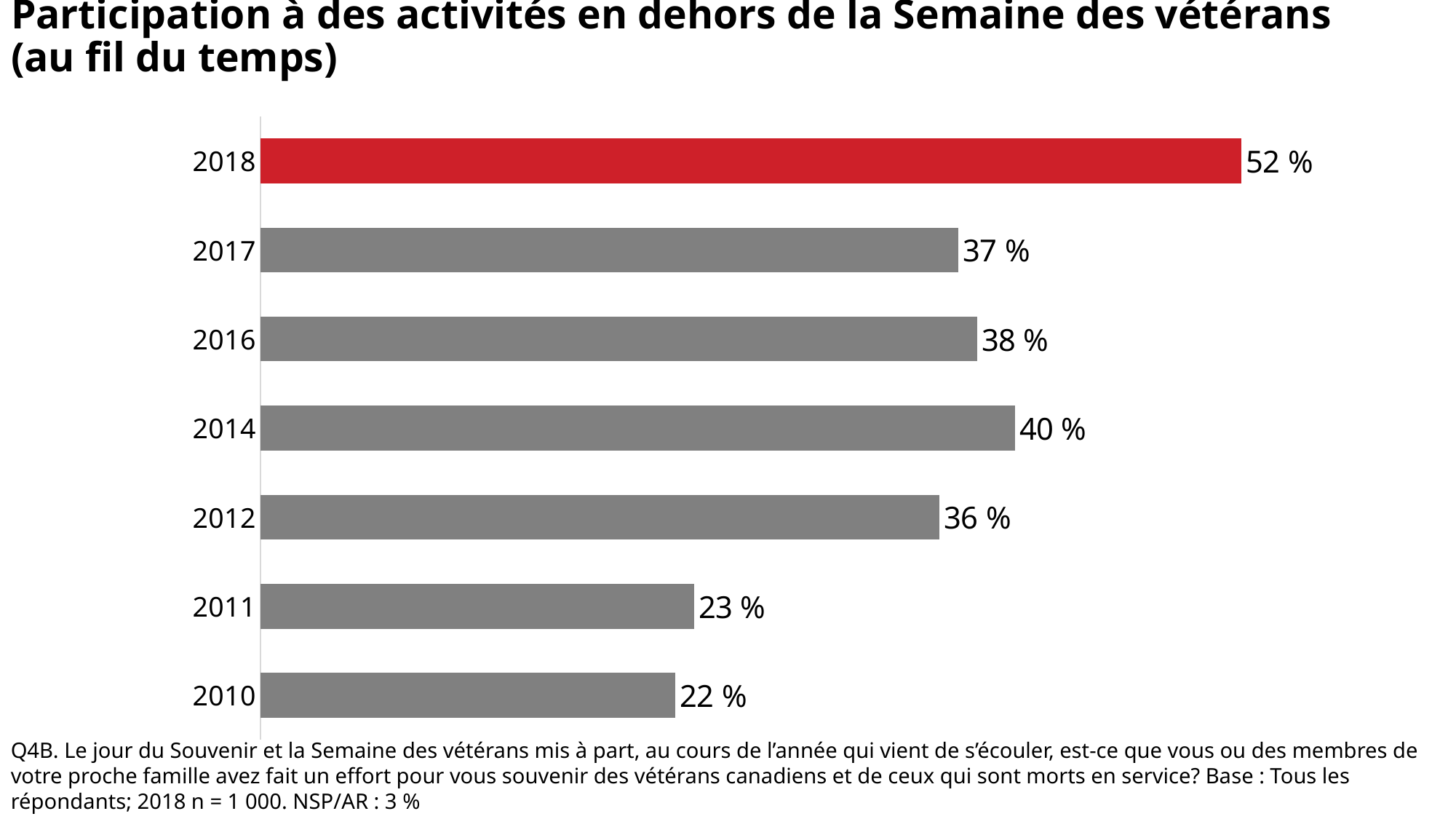
What is the value for 2014? 40 % What kind of chart is this? Bar chart What is the difference between the values for 2011 and 2010? 1 % Which year has the lowest value? 2010 What is the value for 2012? 36 % Which bar is coloured red rather than grey? 2018 Which is larger, the value for 2014 or the value for 2012? 2014 What is the difference between the values for 2018 and 2017? 15 % What is the value for 2018? 52 % Which year has the highest value? 2018 How many years are shown in the chart? 7 What is the value for 2010? 22 %